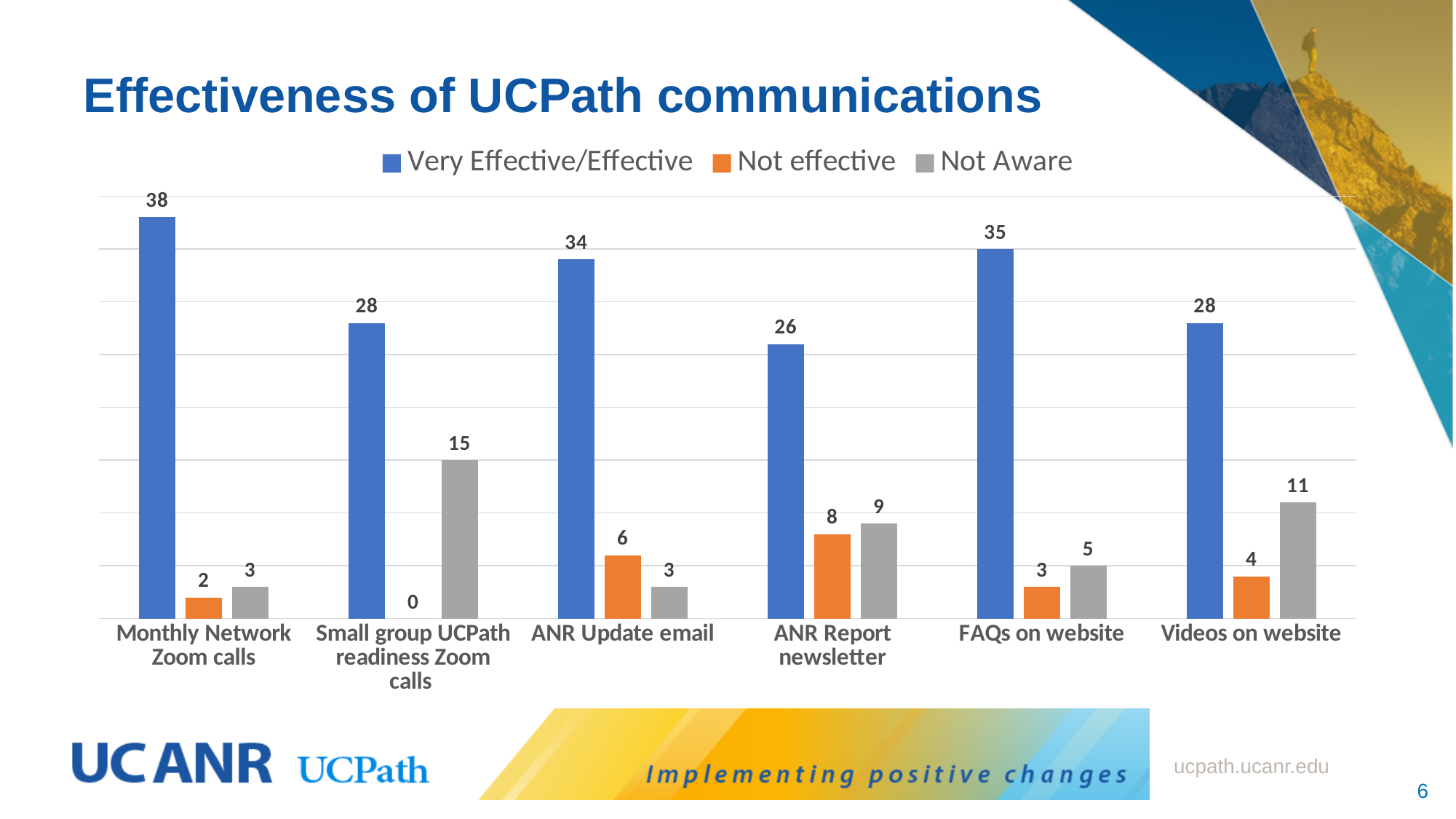
What kind of chart is shown on the slide? Bar chart Which category has the lowest Not effective value? Small group UCPath readiness Zoom calls What is the difference between the Very Effective/Effective values for FAQs on website and Videos on website? 7 Which is larger, the Not Aware value for Videos on website or the Not Aware value for ANR Report newsletter? Videos on website What is the Not effective value for ANR Report newsletter? 8 Which category has the highest Very Effective/Effective value? Monthly Network Zoom calls What is the title of the chart? Effectiveness of UCPath communications What is the Very Effective/Effective value for Monthly Network Zoom calls? 38 What is the Not Aware value for Small group UCPath readiness Zoom calls? 15 How many series does the legend list? 3 Which colour represents the Not Aware series? Grey How many categories are shown on the x axis? 6